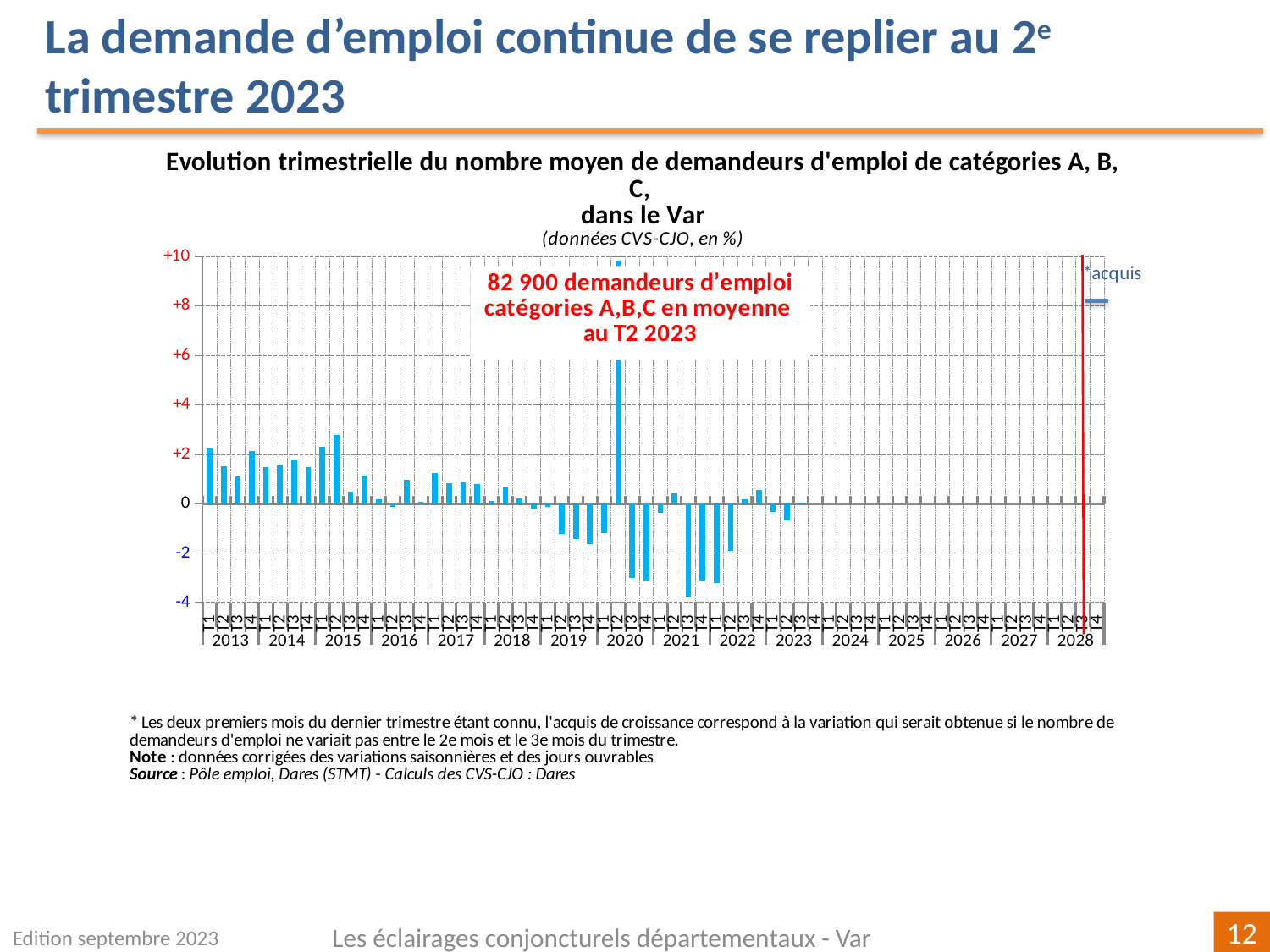
Is the value for T2 2015 greater or less than +2? greater Is the value for T3 2020 greater or less than -2? less Is the value for T2 2020 greater or less than +8? greater Which quarter has the highest value on the chart? T2 2020 What kind of chart is shown on the slide? bar chart Which quarter has the lowest value on the chart? T3 2021 How many years are labelled along the x axis of the chart? 16 According to the text box on the chart, what was the average number of category A, B, C job seekers in T2 2023? 82 900 Which is larger, the value for T2 2020 or the value for T2 2015? T2 2020